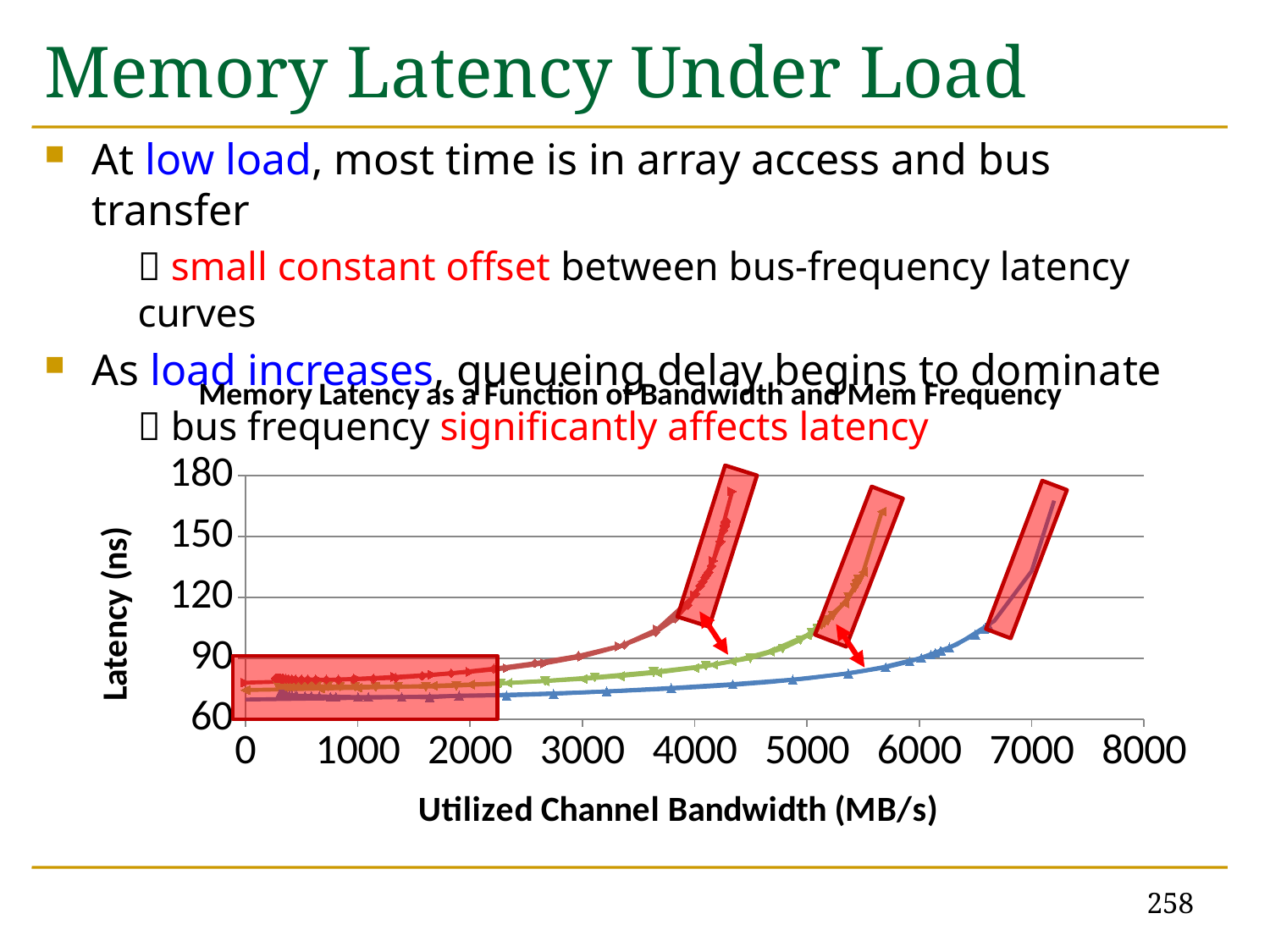
What is the label of the x axis of the chart? Utilized Channel Bandwidth (MB/s) What kind of chart is shown on the slide? line chart Is the latency of the blue curve at 2000 MB/s greater or less than 90 ns? less What is the title of the chart? Memory Latency as a Function of Bandwidth and Mem Frequency Is the latency of the red curve at 4000 MB/s greater or less than 90 ns? greater At 2000 MB/s, which curve has the higher latency, the red curve or the blue curve? red curve How many curves are plotted on the chart? 6 Which curve reaches its steep rise in latency at the lowest bandwidth? red curve What is the highest value shown on the y axis of the chart? 180 As utilized channel bandwidth increases along the x axis, does latency rise or fall? rise Is the latency of the red curve at 2000 MB/s greater or less than 90 ns? less